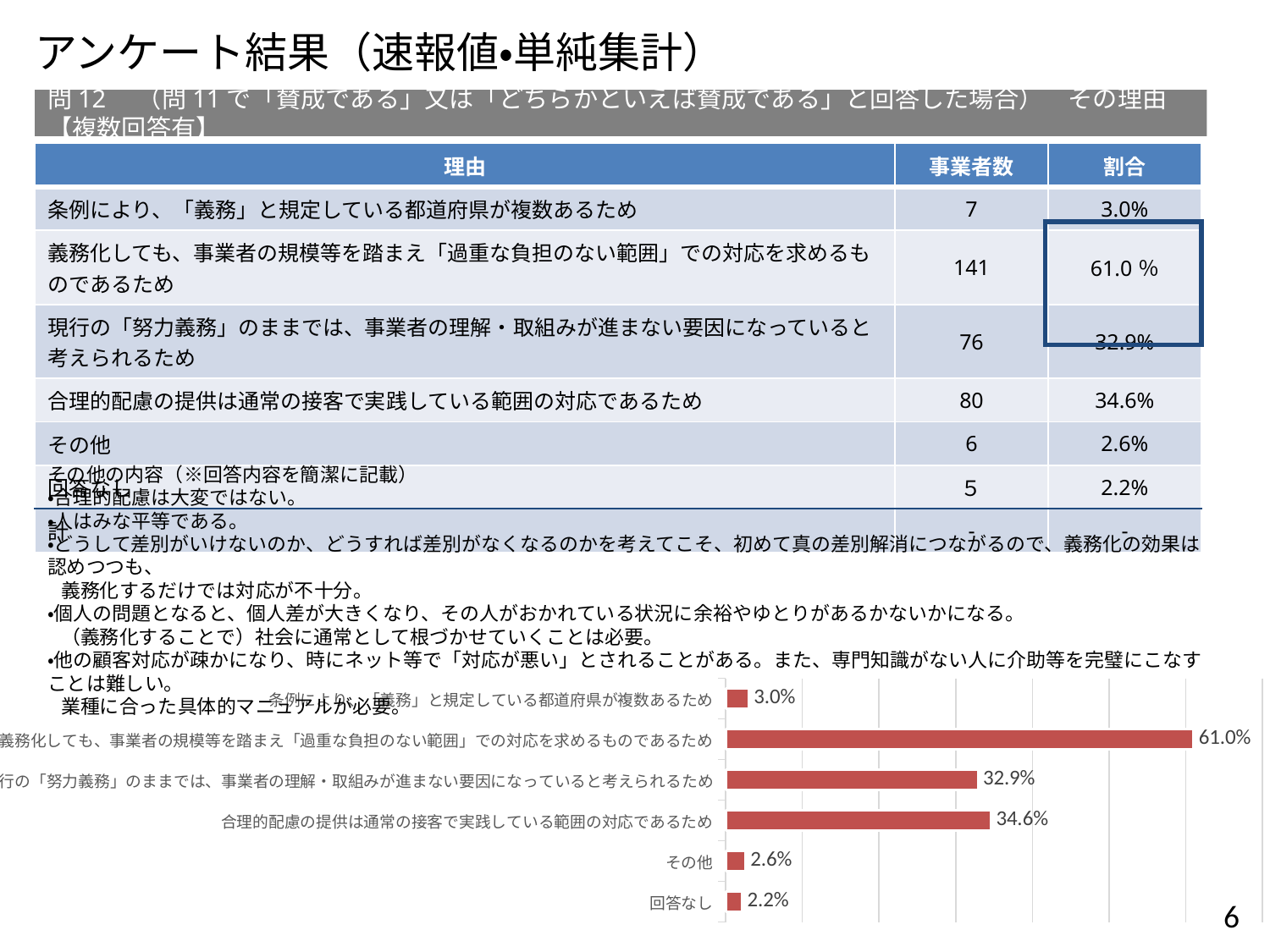
In the bar chart, what is the difference between the value for 合理的配慮の提供は通常の接客で実践している範囲の対応であるため (34.6%) and the value for その他 (2.6%)? 32.0% What kind of chart is shown at the bottom of the slide? bar chart Which category has the lowest value in the bar chart? 回答なし Which category has the highest value in the bar chart? 義務化しても、事業者の規模等を踏まえ「過重な負担のない範囲」での対応を求めるものであるため In the bar chart, what is the value for 合理的配慮の提供は通常の接客で実践している範囲の対応であるため? 34.6% In the bar chart, which is larger: the value for 合理的配慮の提供は通常の接客で実践している範囲の対応であるため or the value for the reason about the current 「努力義務」? 合理的配慮の提供は通常の接客で実践している範囲の対応であるため What colour are the bars in the bar chart? red In the bar chart, what is the value for 回答なし? 2.2% In the bar chart, what is the value for the reason about requiring a response within a range that is not an excessive burden (「過重な負担のない範囲」での対応を求めるものであるため)? 61.0% In the bar chart, what is the value for その他? 2.6% In the bar chart, what is the value for the reason that the current 「努力義務」 is a factor preventing progress in business operators' understanding and efforts? 32.9% How many categories (bars) does the bar chart show? 6